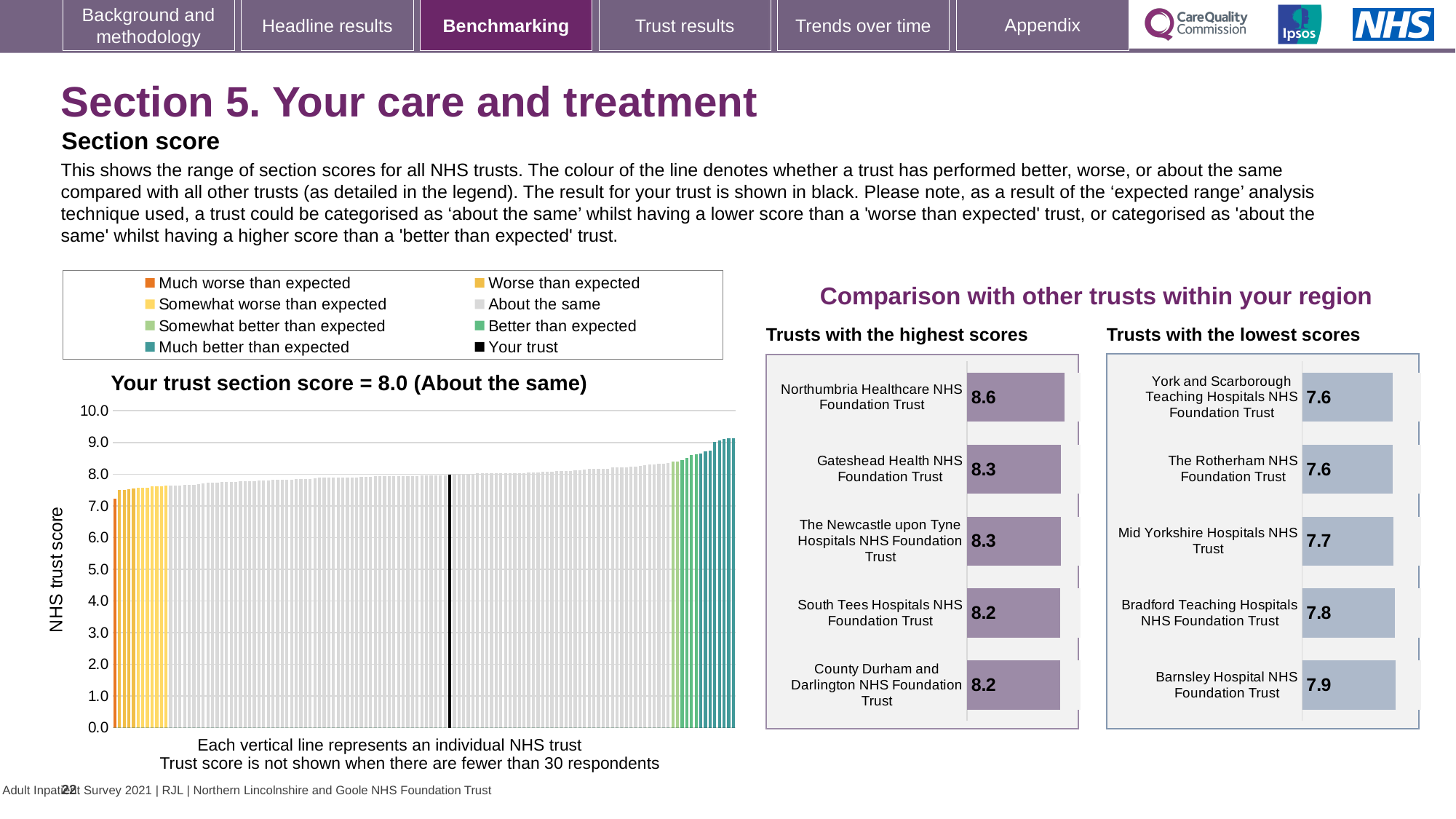
In the 'Your trust section score' chart, do the trust scores rise or fall from left to right? Rise In the 'Trusts with the highest scores' chart, which trust has the highest score? Northumbria Healthcare NHS Foundation Trust In the 'Your trust section score' chart, what is the section score for your trust? 8.0 How many entries does the legend above the 'Your trust section score' chart list? 8 In the 'Trusts with the highest scores' chart, what is the score for Northumbria Healthcare NHS Foundation Trust? 8.6 In the 'Trusts with the lowest scores' chart, what is the score for Mid Yorkshire Hospitals NHS Trust? 7.7 In the 'Trusts with the lowest scores' chart, which trust has the highest score? Barnsley Hospital NHS Foundation Trust In the 'Trusts with the lowest scores' chart, what is the difference between the scores of Barnsley Hospital NHS Foundation Trust and The Rotherham NHS Foundation Trust? 0.3 What kind of chart is the 'Your trust section score' chart on the left? Bar chart In the 'Trusts with the highest scores' chart, what is the difference between the scores of Northumbria Healthcare NHS Foundation Trust and County Durham and Darlington NHS Foundation Trust? 0.4 How many trusts are listed in the 'Trusts with the highest scores' chart? 5 In the 'Trusts with the lowest scores' chart, which has the higher score: Mid Yorkshire Hospitals NHS Trust or Bradford Teaching Hospitals NHS Foundation Trust? Bradford Teaching Hospitals NHS Foundation Trust